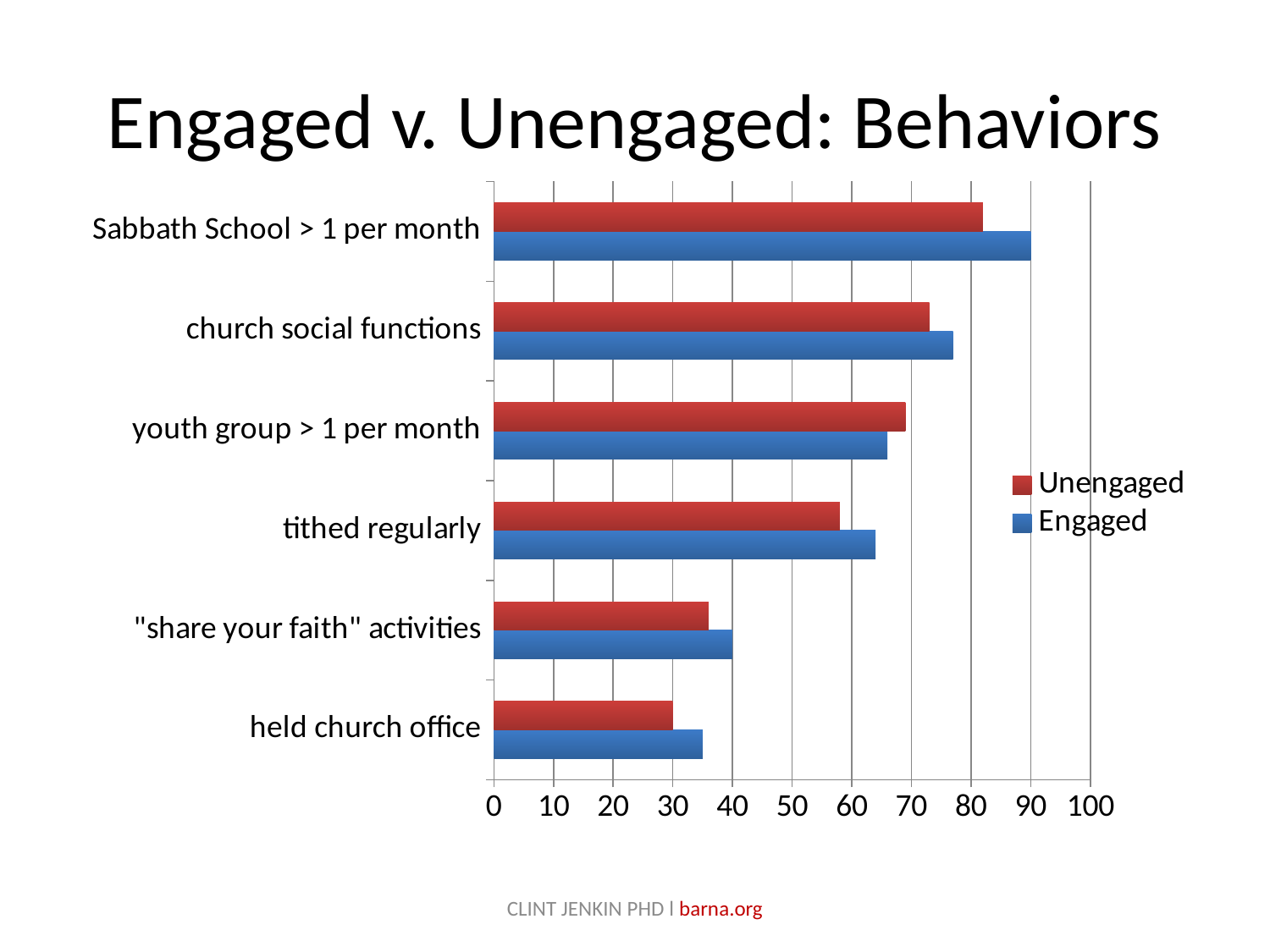
What colour represents the Engaged series in the legend? blue How many behavior categories are plotted on the chart? 6 Is the Engaged value for "tithed regularly" greater or less than 60? greater How many series does the legend list? 2 What is the title of the chart? Engaged v. Unengaged: Behaviors Is the Unengaged value for "Sabbath School > 1 per month" greater or less than 80? greater For "tithed regularly", which is larger: the Engaged value or the Unengaged value? Engaged Which category has the lowest Unengaged value? held church office What kind of chart is shown on the slide? bar chart Is the Unengaged value for "church social functions" greater or less than 70? greater What is the Engaged value for "Sabbath School > 1 per month"? 90 Which category has the highest Engaged value? Sabbath School > 1 per month